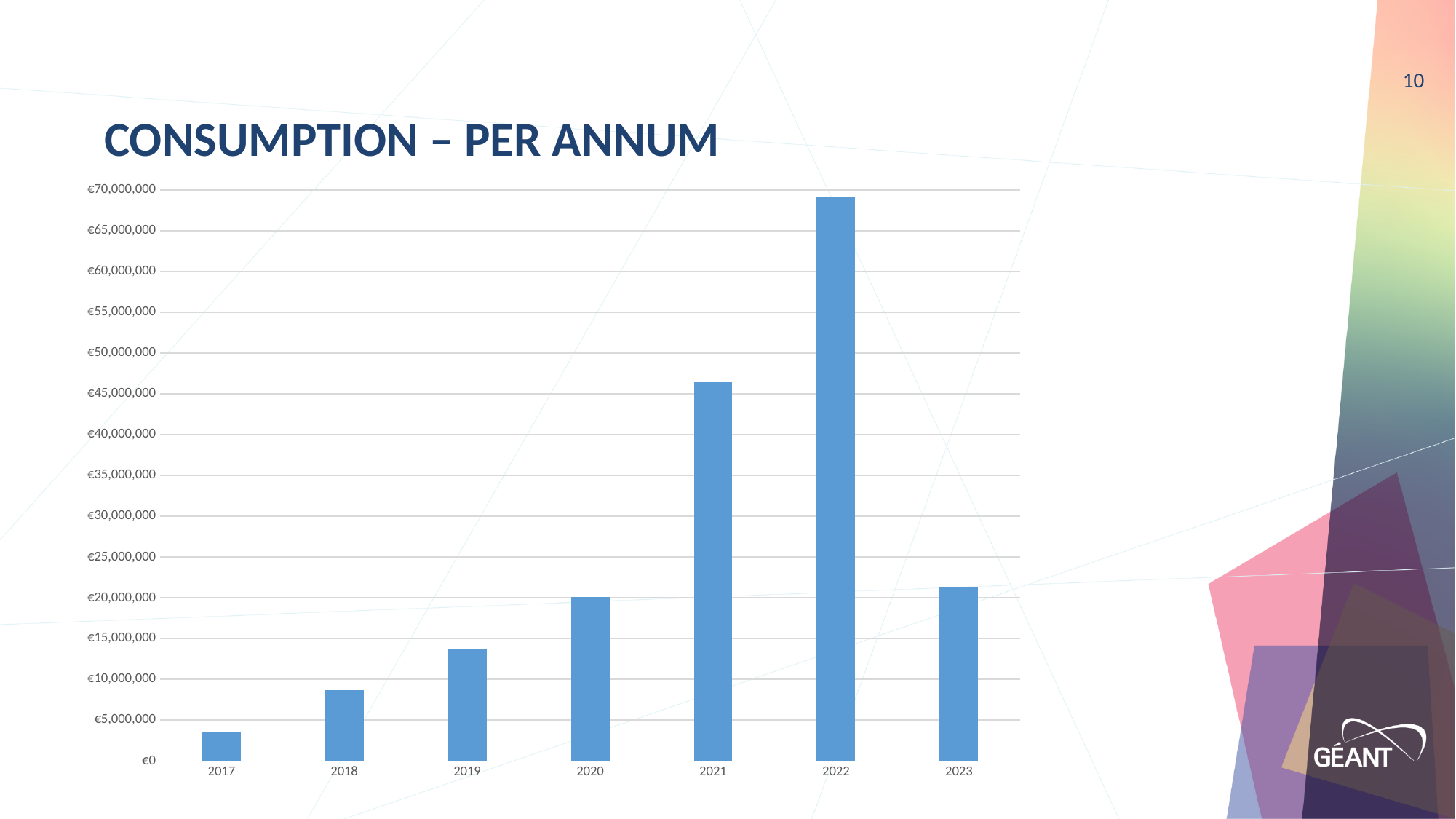
Which year has the lowest consumption? 2017 Which year has the higher consumption, 2021 or 2023? 2021 Which year has the higher consumption, 2019 or 2020? 2020 Is the value for 2021 greater or less than €40,000,000? greater Is the value for 2018 greater or less than €10,000,000? less Is the value for 2017 greater or less than €5,000,000? less How many years are shown on the x axis of the chart? 7 Which year has the highest consumption? 2022 What is the title of the chart? CONSUMPTION – PER ANNUM What kind of chart is shown on the slide? bar chart Does consumption rise or fall from 2017 to 2022? rise